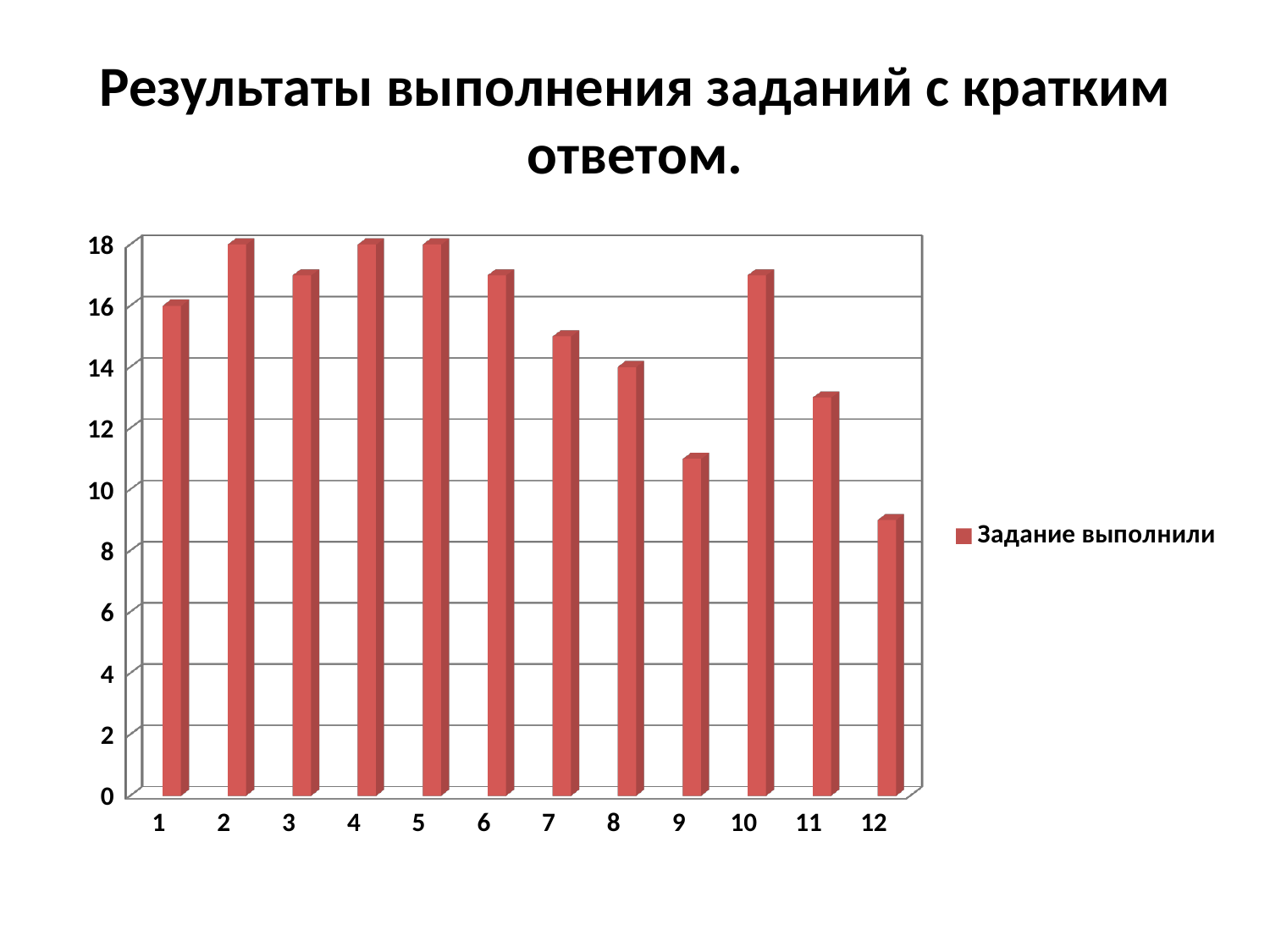
What is the value for task 8? 14 Which is larger, the value for task 2 or the value for task 12? task 2 What type of chart is shown on the slide? bar chart What is the difference between the values for task 2 and task 8? 4 Is the value for task 3 greater or less than 16? greater Which task has the lowest value? 12 What is the value for task 2? 18 How many categories (tasks) are shown on the x axis? 12 Is the value for task 9 greater or less than 10? greater What is the name of the series shown in the legend? Задание выполнили How many series does the legend list? 1 Is the value for task 12 greater or less than 10? less